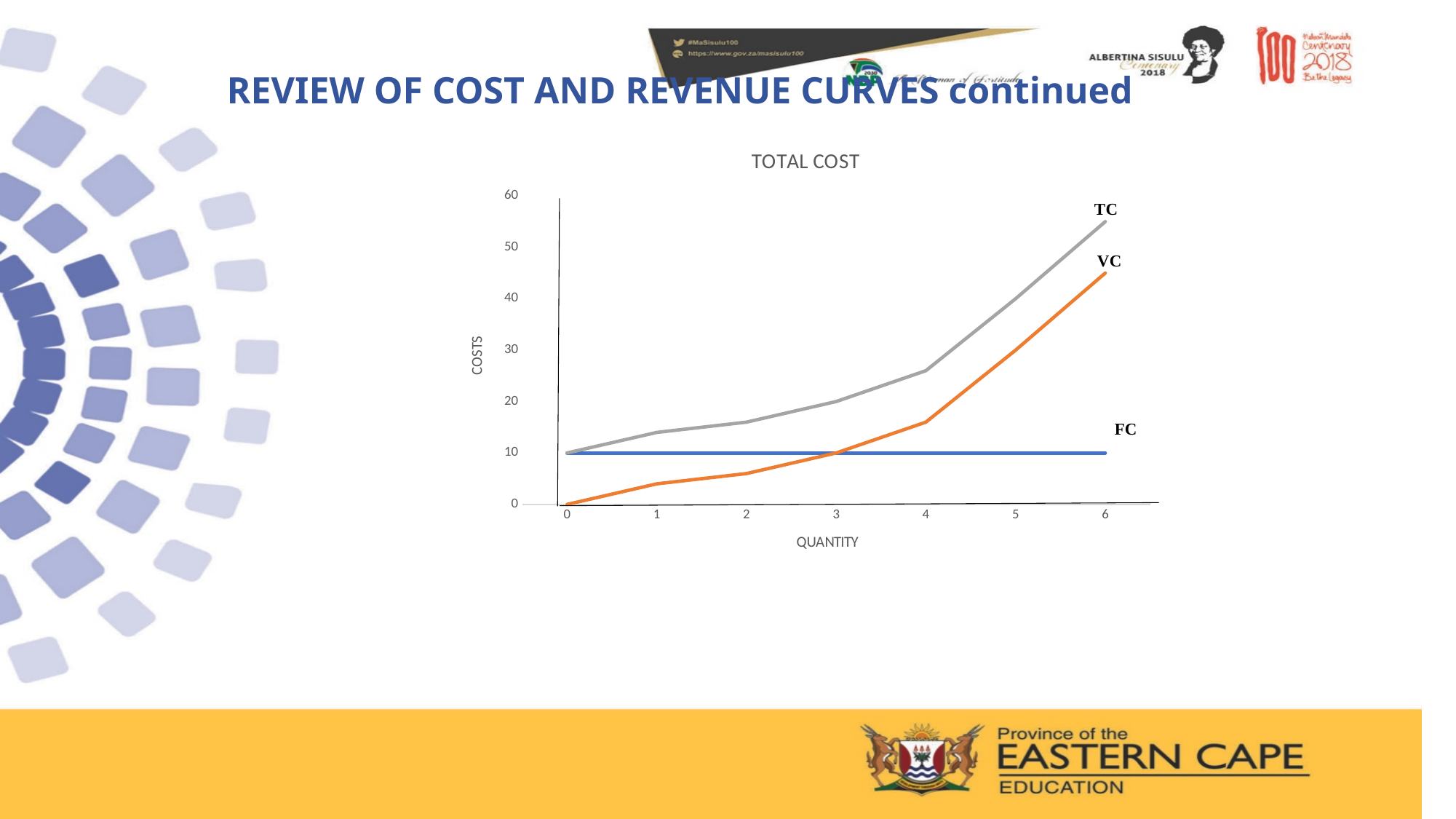
How many cost curves are plotted on the chart? 3 Does the TC curve rise or fall as quantity increases? Rises What is the value of TC at quantity 0? 10 Does the FC curve rise, fall or stay constant as quantity increases? Stays constant Is the value of VC at quantity 2 greater or less than 10? less At quantity 6, which curve has the higher value, TC or VC? TC What is the label on the vertical axis of the chart? COSTS What type of chart is shown on the slide? Line chart What is the value of VC at quantity 0? 0 Is the value of TC at quantity 6 greater or less than 50? greater What is the title of the chart? TOTAL COST What is the value of the FC curve across all quantities? 10